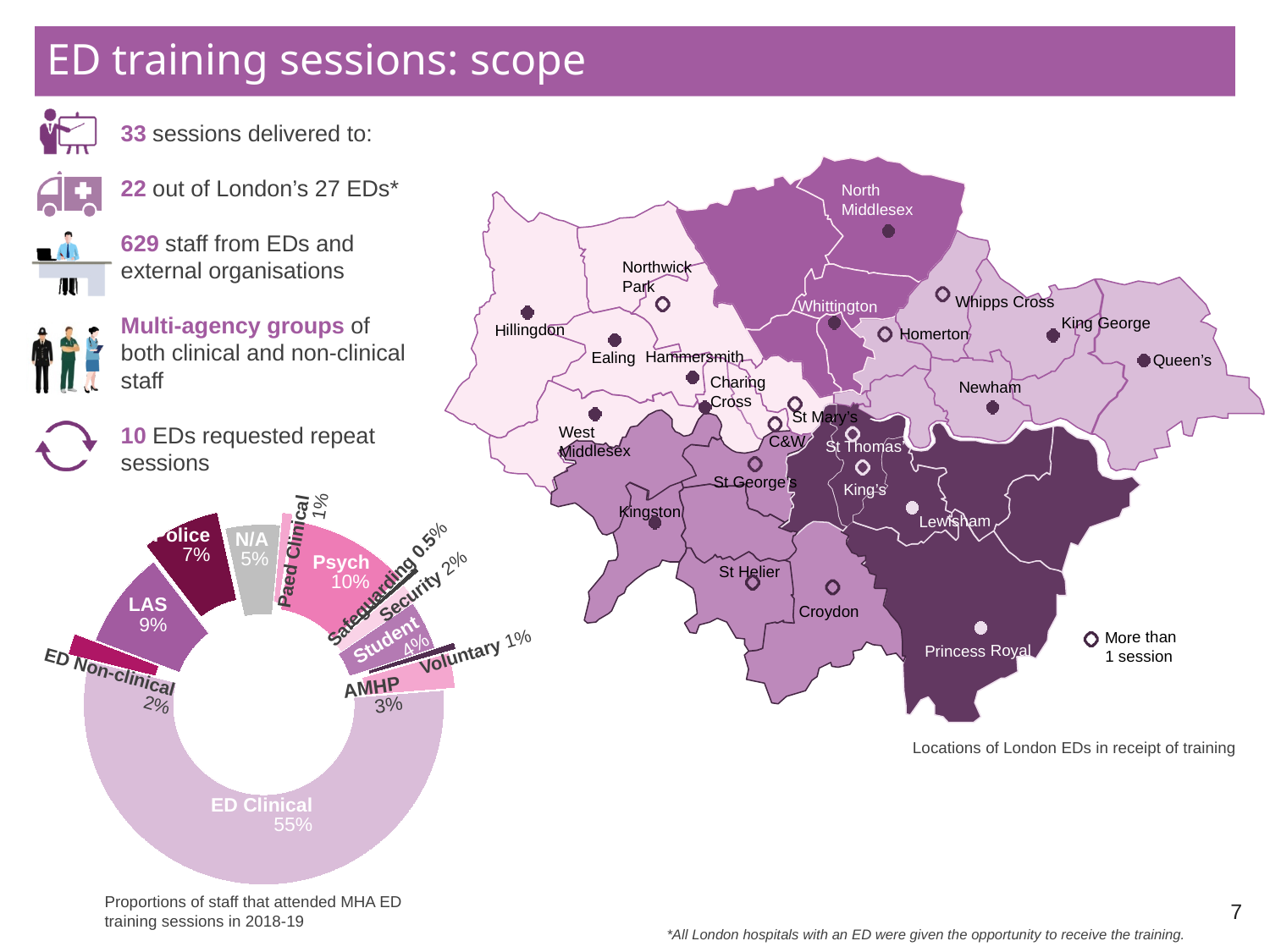
How many staff groups are shown in the chart of proportions of staff that attended training sessions? 12 What percentage of attendees were Psych staff? 10% What share of attendees were Police? 7% Which group makes up the smallest share of attendees? Safeguarding How many percentage points larger is the Psych share than the LAS share? 1% Which group has the larger share of attendees, Police or N/A? Police Which group makes up the largest share of staff that attended the training sessions? ED Clinical What type of chart is used to show the proportions of staff that attended MHA ED training sessions? Pie (donut) chart What percentage of attendees were from LAS? 9% What percentage of attendees were Safeguarding staff? 0.5% What share of staff that attended MHA ED training sessions were ED Clinical? 55% What percentage of attendees were AMHP? 3%